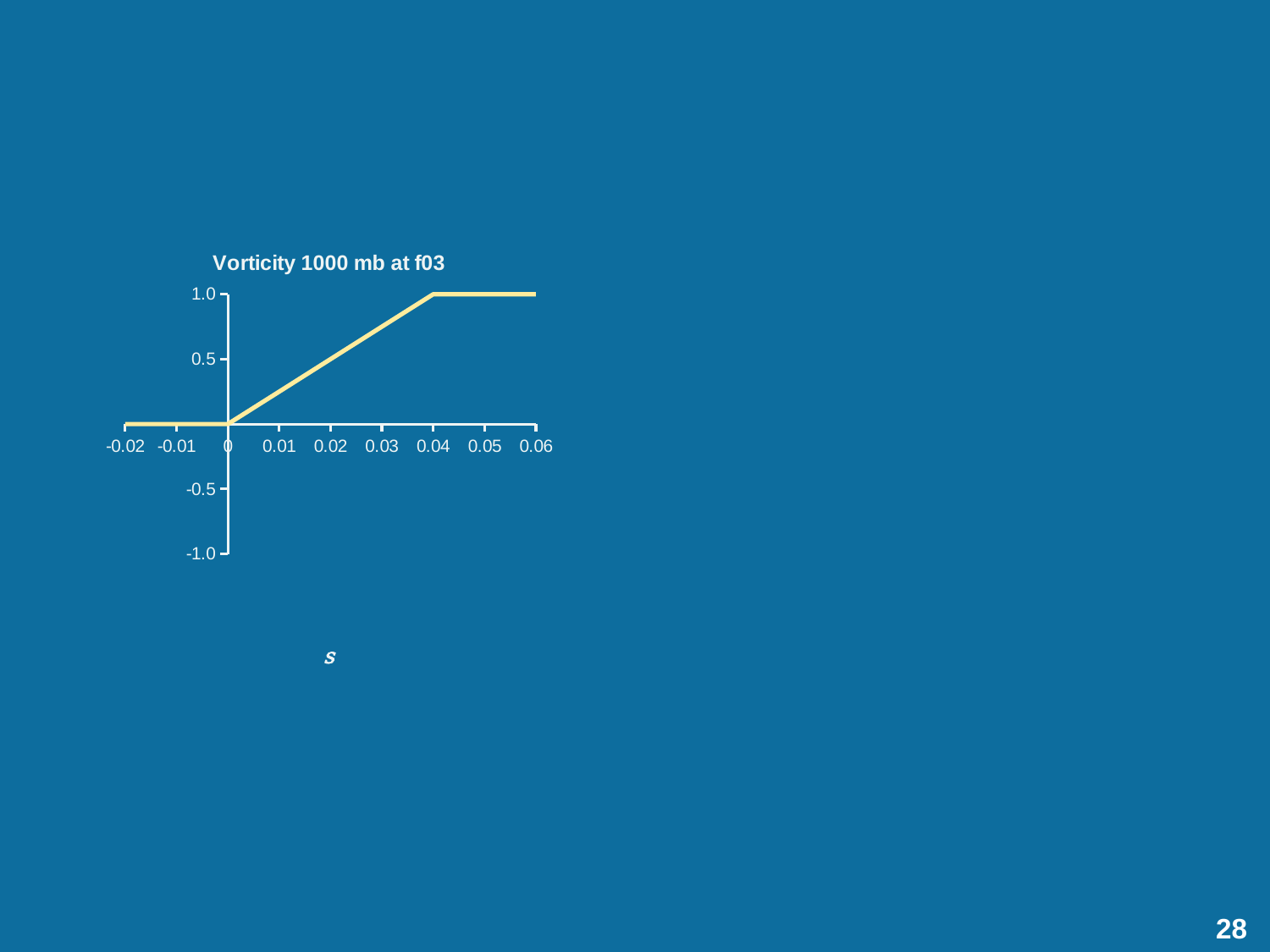
What is the value of the line at x = 0.02? 0.5 Is the value of the line at x = 0.01 greater or less than 0.5? less What is the value of the line at x = 0.06? 1.0 Is the value of the line at x = 0.03 greater or less than 0.5? greater What kind of chart is shown on the slide? line chart What is the label shown below the x axis of the chart? s What is the value of the line at x = -0.02? 0 What is the highest value reached by the line? 1.0 Does the line rise or fall between x = 0 and x = 0.04? rise What is the title of the chart? Vorticity 1000 mb at f03 What is the value of the line at x = 0? 0 What is the value of the line at x = 0.04? 1.0